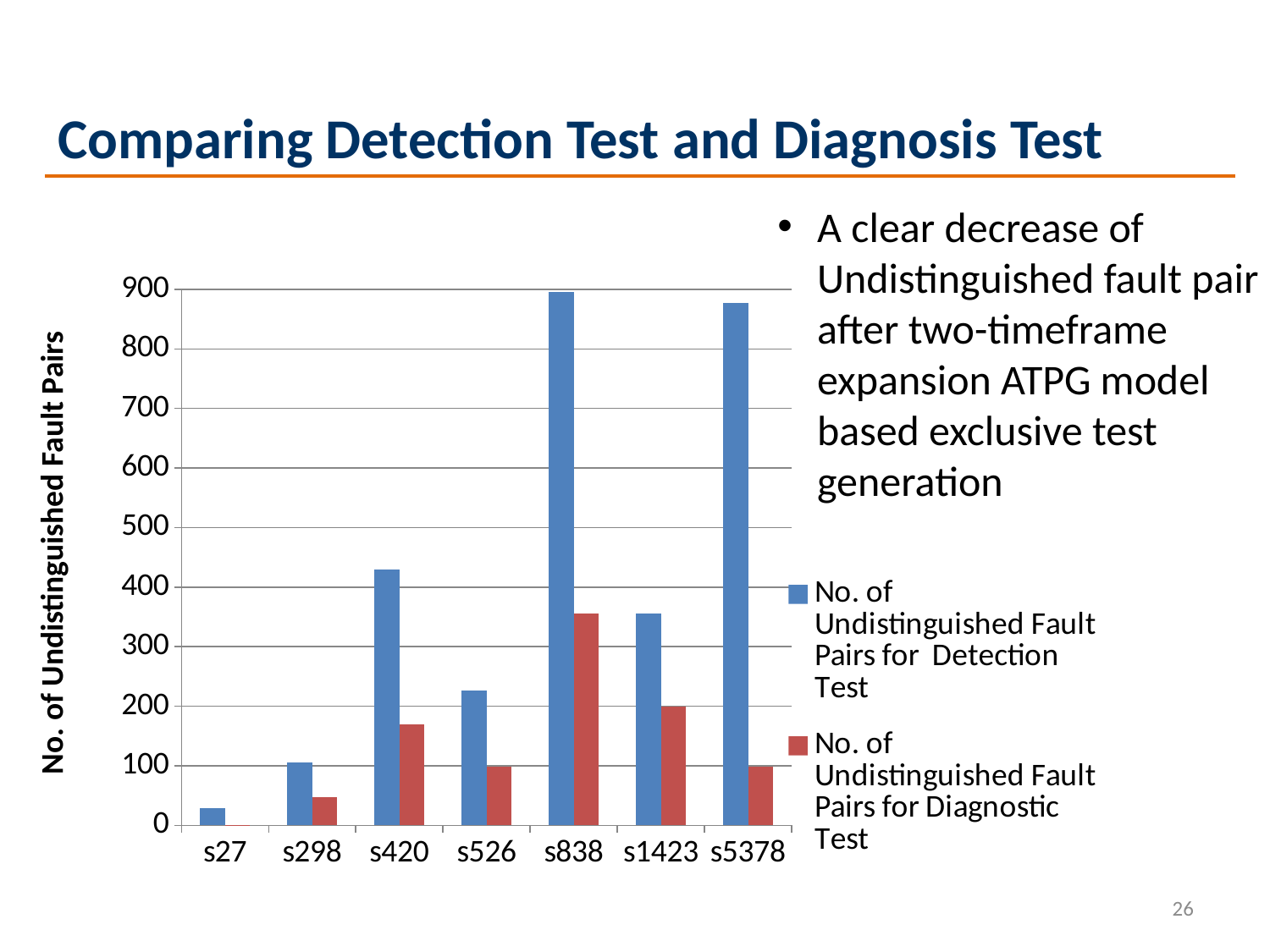
What kind of chart is shown on the slide? bar chart Is the number of undistinguished fault pairs for the Detection Test for s298 greater or less than 200? less How many circuit categories are shown on the x axis of the chart? 7 Which has more undistinguished fault pairs for the Detection Test, s420 or s1423? s420 Is the number of undistinguished fault pairs for the Diagnostic Test for s838 greater or less than 300? greater Which has more undistinguished fault pairs for the Diagnostic Test, s1423 or s526? s1423 How many series does the chart's legend list? 2 Which category has the highest number of undistinguished fault pairs for the Diagnostic Test? s838 Is the number of undistinguished fault pairs for the Detection Test for s420 greater or less than 400? greater What is the title of the chart's vertical axis? No. of Undistinguished Fault Pairs Which category has the lowest number of undistinguished fault pairs for the Detection Test? s27